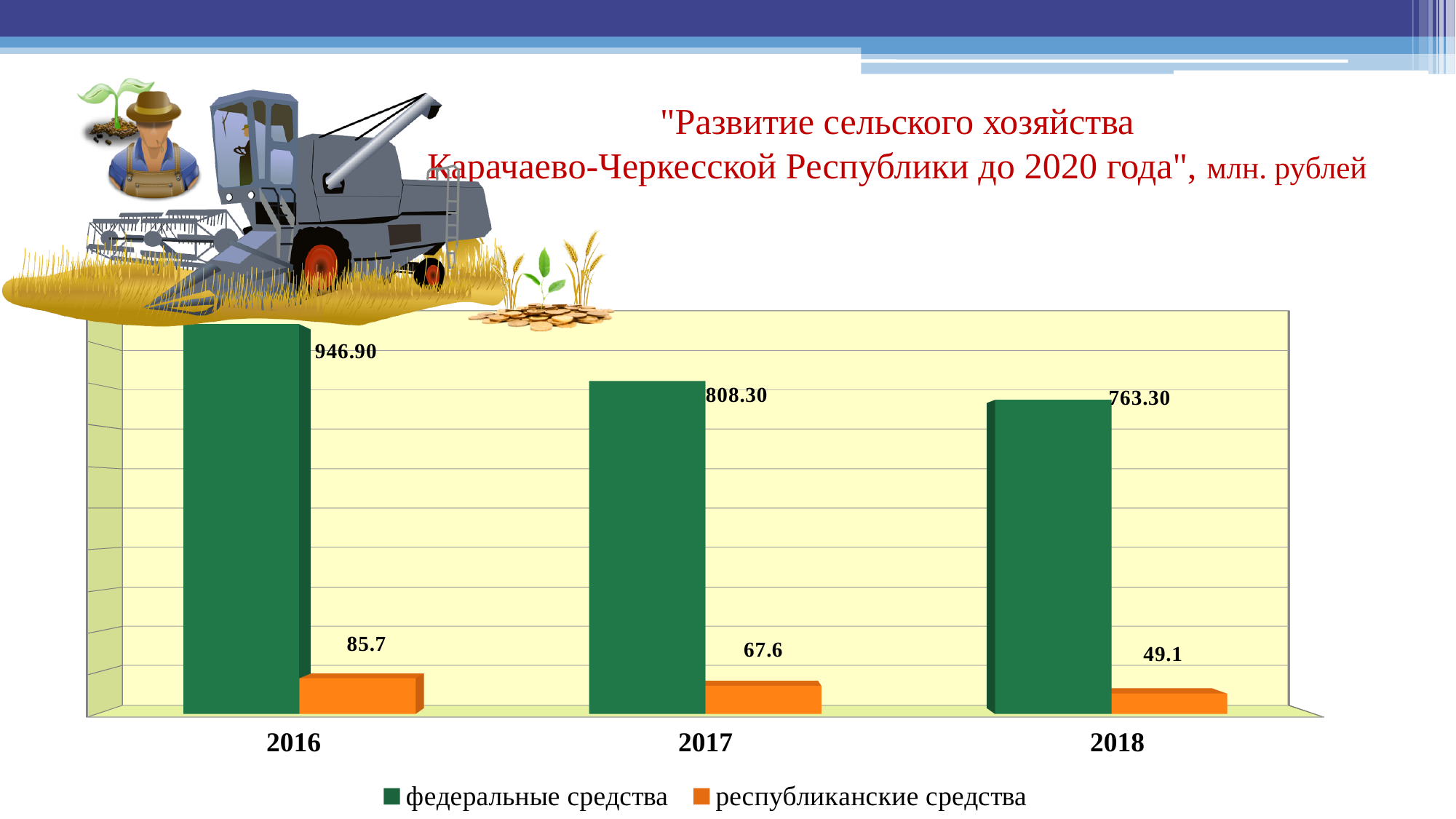
How many years are shown on the x axis? 3 How many series does the legend list? 2 What is the value of республиканские средства for 2017? 67.6 What is the value of республиканские средства for 2018? 49.1 Which is larger: федеральные средства in 2017 or in 2018? 2017 What is the difference between федеральные средства in 2016 and 2018? 183.60 What is the value of федеральные средства for 2016? 946.90 Do the values of федеральные средства rise or fall from 2016 to 2018? fall What is the difference between республиканские средства in 2016 and 2017? 18.1 In which year is федеральные средства the highest? 2016 In which year is республиканские средства the lowest? 2018 What is the value of федеральные средства for 2017? 808.30